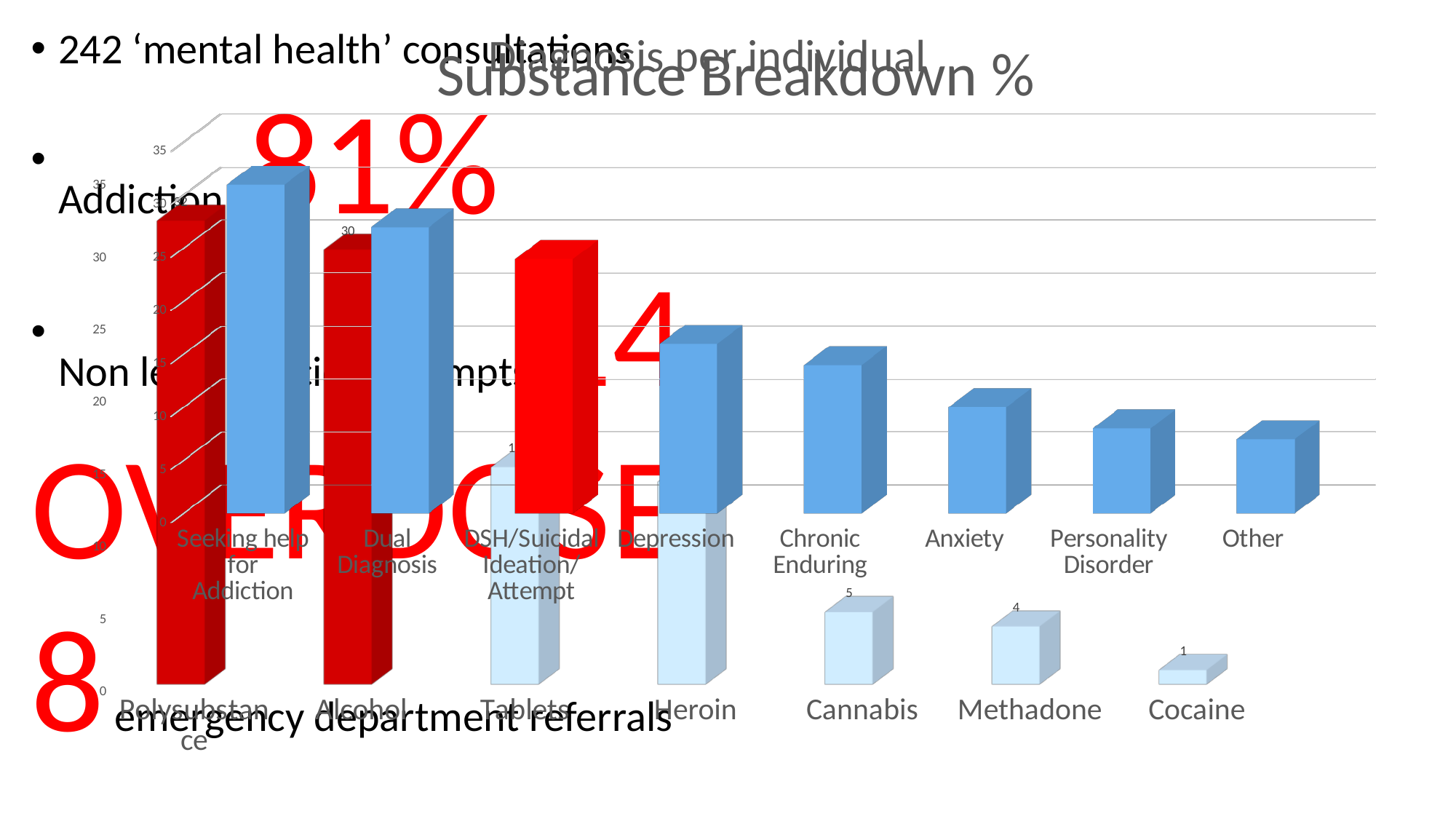
In the Substance Breakdown % chart, what is the value for Cocaine? 1 How many diagnosis categories are shown in the Diagnosis per individual chart? 8 In the Substance Breakdown % chart, what is the value for Cannabis? 5 In the Substance Breakdown % chart, what is the value for Methadone? 4 In the Diagnosis per individual chart, which category has the lowest value? Other In the Diagnosis per individual chart, which is larger, Depression or Anxiety? Depression How many substance categories are shown in the Substance Breakdown % chart? 7 In the Substance Breakdown % chart, which is larger, Cannabis or Methadone? Cannabis In the Substance Breakdown % chart, what is the difference between the values for Cannabis and Cocaine? 4 In the Substance Breakdown % chart, which substance has the lowest value? Cocaine What kind of chart is the Substance Breakdown % chart? Bar chart In the Diagnosis per individual chart, which category has the highest value? Seeking help for Addiction